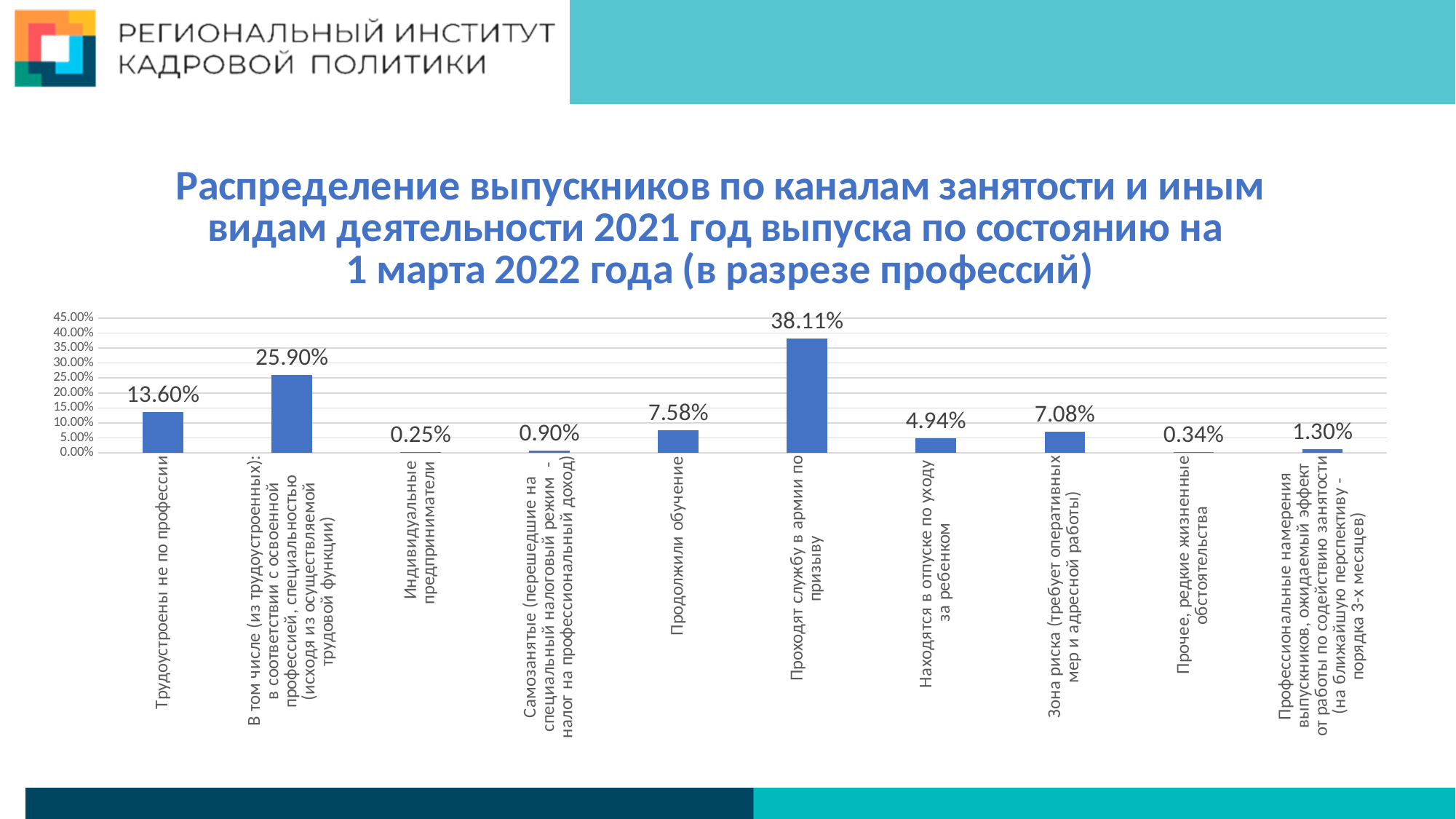
What is the value for "Проходят службу в армии по призыву"? 38.11% How many categories are shown on the chart? 10 Which category has the lowest value? Индивидуальные предприниматели Which category has the highest value? Проходят службу в армии по призыву What is the value for "Продолжили обучение"? 7.58% What kind of chart is shown on the slide? bar chart What is the value for "Находятся в отпуске по уходу за ребенком"? 4.94% Which is larger: the value for "Продолжили обучение" or the value for "Зона риска (требует оперативных мер и адресной работы)"? Продолжили обучение What is the difference between the values for "Проходят службу в армии по призыву" and "Трудоустроены не по профессии"? 24.51% What is the value for "Трудоустроены не по профессии"? 13.60% What is the value for "Индивидуальные предприниматели"? 0.25% Is the value for "Проходят службу в армии по призыву" greater or less than 35.00%? greater